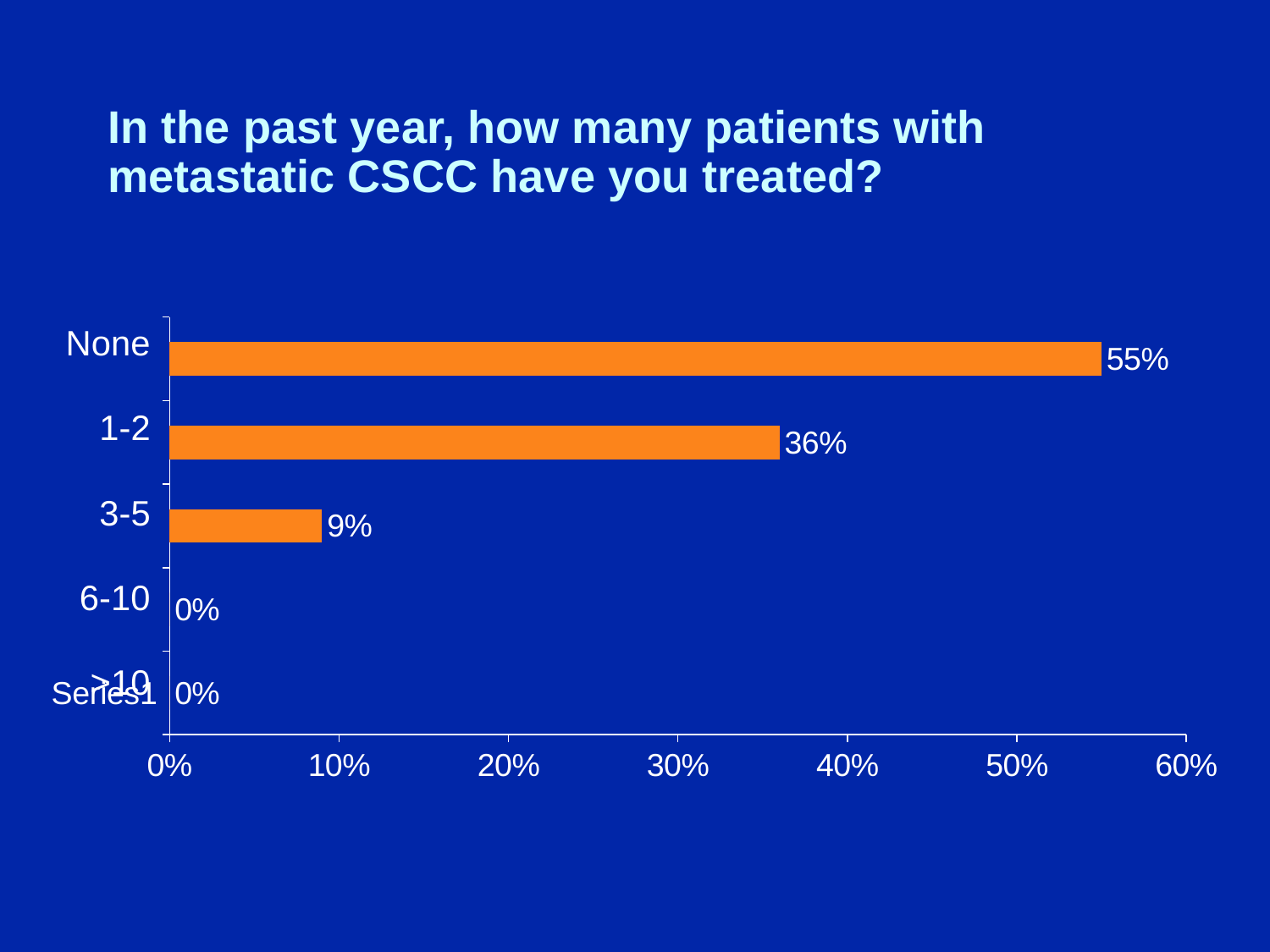
What is the difference between the values for "None" and "1-2"? 19% Which category has the highest value? None How many categories are shown on the chart? 5 Which is larger, the value for "1-2" or the value for "3-5"? 1-2 Is the value for "None" greater or less than 50%? greater What is the maximum value shown on the horizontal axis? 60% What is the value for the "3-5" category? 9% What kind of chart is shown on the slide? Bar chart What is the value for the "1-2" category? 36% What is the difference between the values for "1-2" and "3-5"? 27% What is the value for the "6-10" category? 0% What percentage of respondents answered "None"? 55%